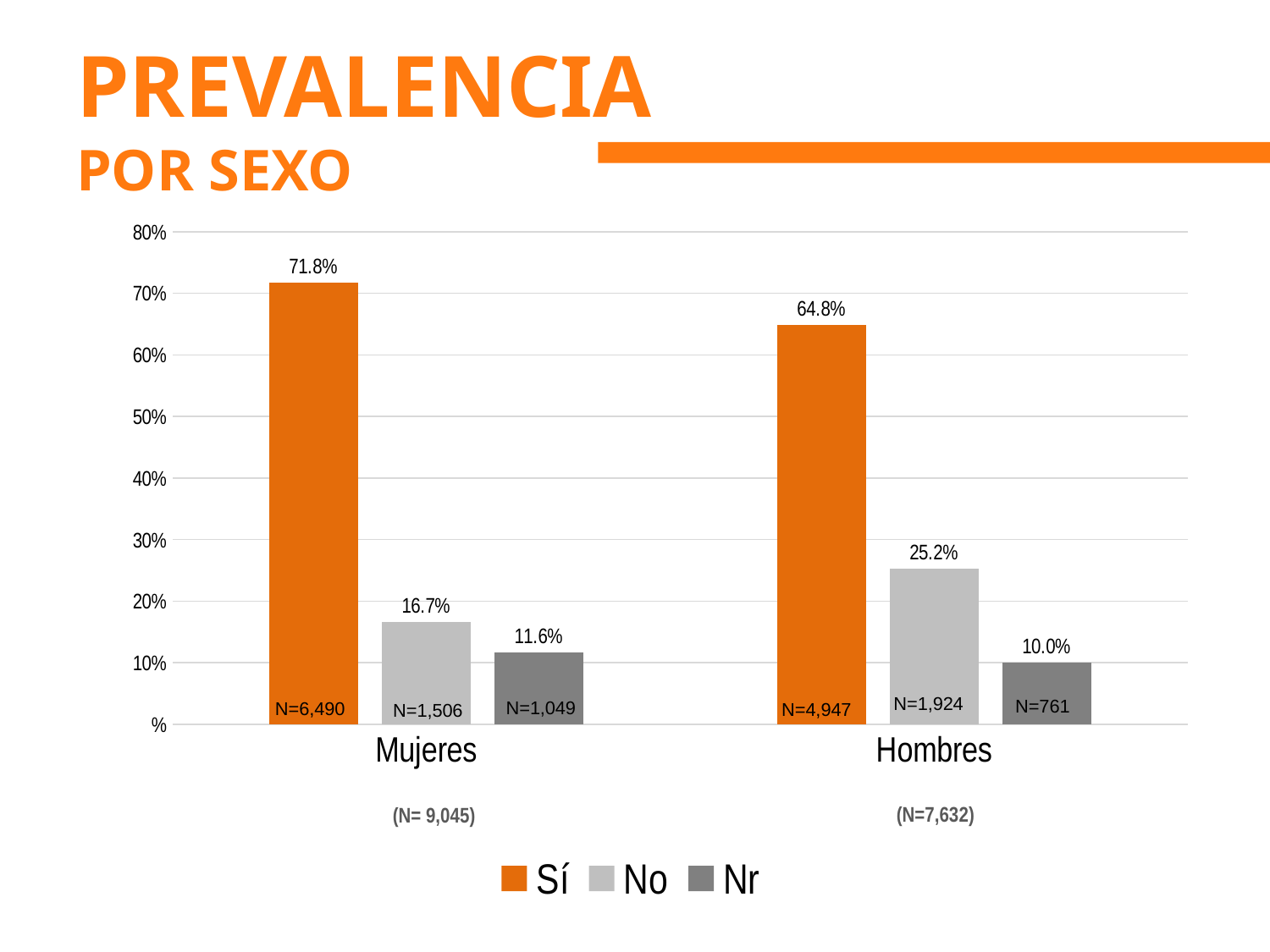
Which series has the lowest value in the Mujeres group? Nr What is the difference between the Sí values for Mujeres and Hombres? 7.0% What kind of chart is shown on the slide? Bar chart What is the value for Nr in the Mujeres group? 11.6% Which series has the highest value in the Hombres group? Sí What colour are the Sí bars? Orange What is the value for No in the Hombres group? 25.2% Which group has the larger value for No, Mujeres or Hombres? Hombres How many series does the legend list? 3 What is the value for Sí in the Mujeres group? 71.8% How many groups are shown on the x axis? 2 What is the N shown on the Sí bar for Hombres? N=4,947